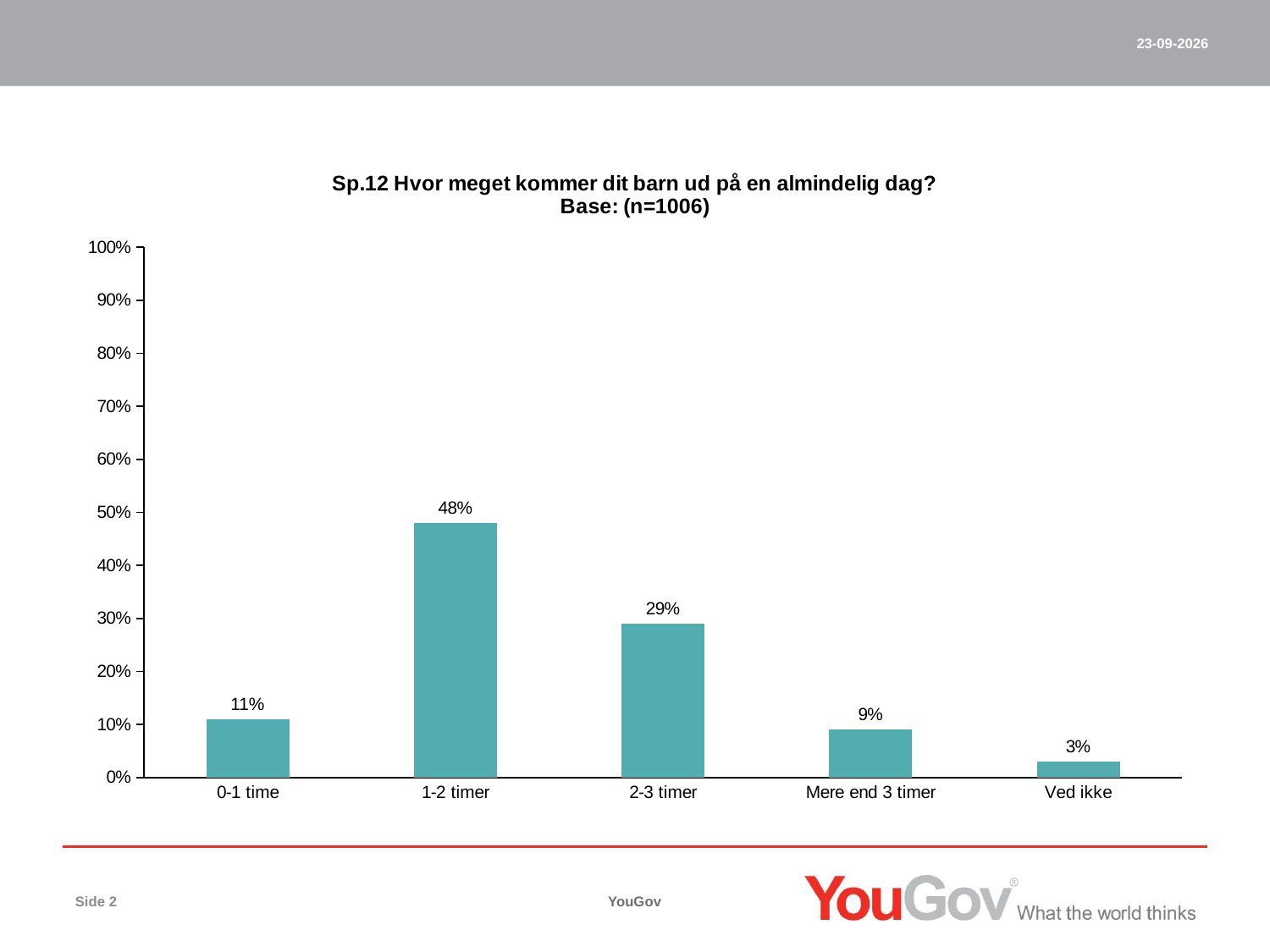
Which category has the lowest value? Ved ikke Which is larger, the value for "0-1 time" or the value for "Mere end 3 timer"? 0-1 time Which category has the highest value? 1-2 timer What is the highest value shown on the y axis? 100% What is the base size (n) stated in the chart title? n=1006 What is the difference between the values for "1-2 timer" and "2-3 timer"? 19% What kind of chart is shown on the slide? bar chart How many categories are shown on the x axis? 5 Is the value for "2-3 timer" greater or less than 20%? greater What is the value for "1-2 timer"? 48% What is the value for "Ved ikke"? 3% What is the value for "Mere end 3 timer"? 9%